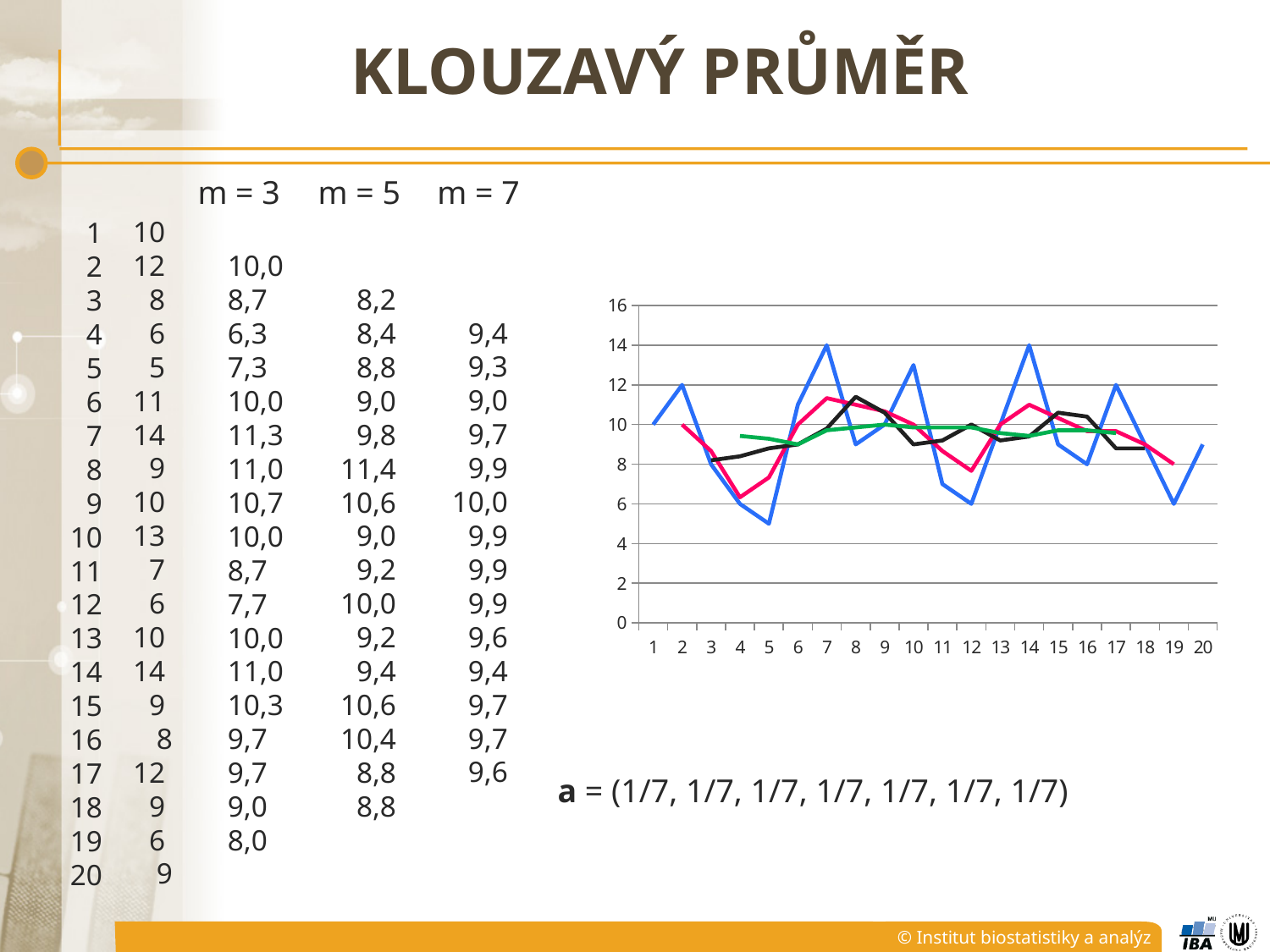
Which is larger on the blue line: the value at point 7 or the value at point 8? point 7 What is the value of the blue line at point 7? 14 Is the value of the blue line at point 5 greater or less than 6? less Does the blue line rise or fall from point 17 to point 19? fall What kind of chart is shown on the slide? line chart Is the value of the blue line at point 14 greater or less than 12? greater How many lines are plotted on the chart? 4 What is the value of the blue line at point 12? 6 How many points are labelled along the x axis of the chart? 20 What colour is the line with the largest swings (the raw data) on the chart? blue Is the value of the blue line at point 10 greater or less than 12? greater At which x-axis point does the blue line reach its lowest value? 5